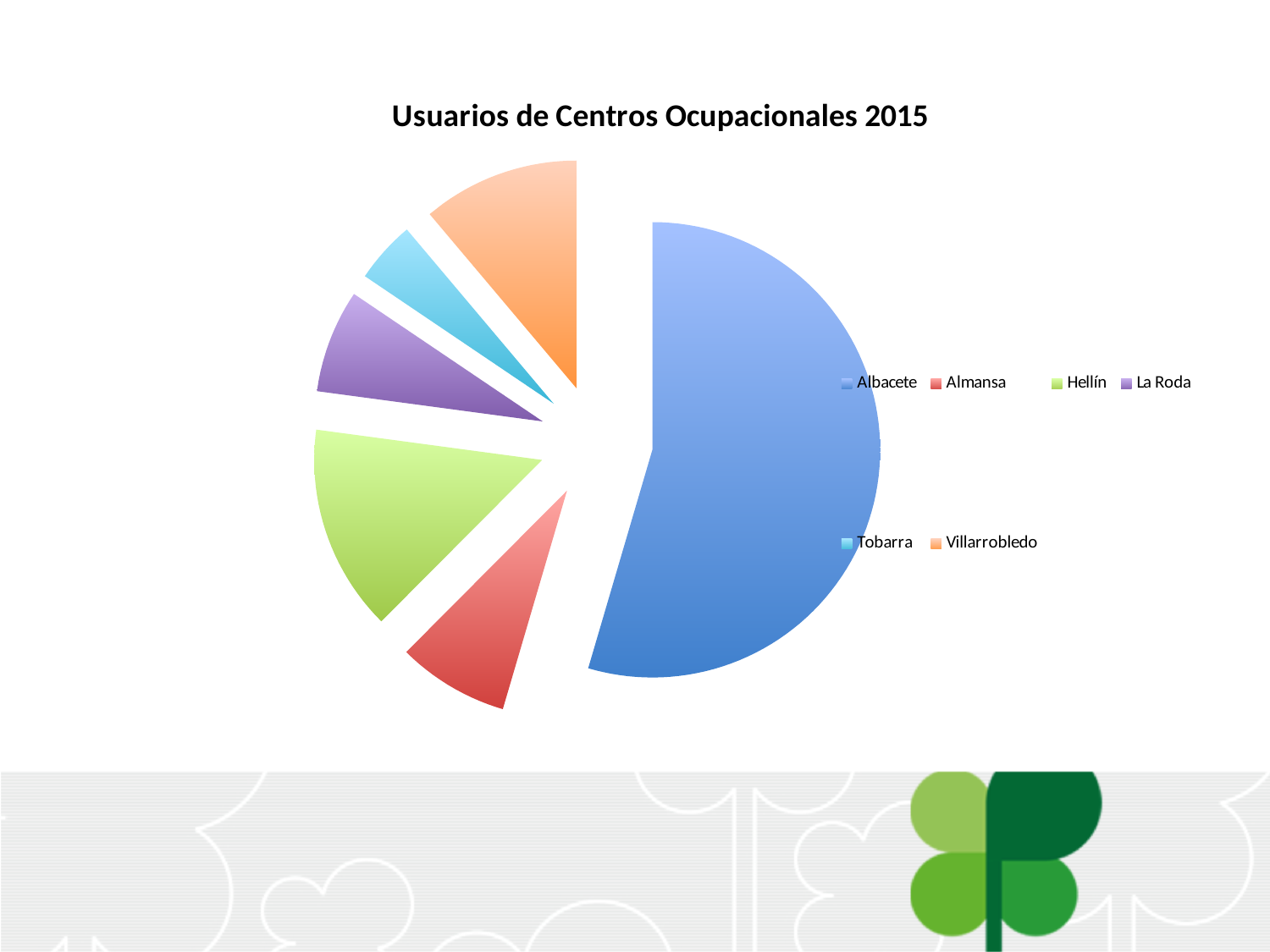
Which slice is larger, Hellín or La Roda? Hellín How many slices does the pie chart have? 6 What colour is the Albacete slice in the pie chart? blue What is the title of the chart? Usuarios de Centros Ocupacionales 2015 Which slice is larger, Albacete or Hellín? Albacete What kind of chart is shown on the slide? pie chart Which slice is larger, Hellín or Tobarra? Hellín Which category has the smallest slice of the pie? Tobarra Which category has the largest slice of the pie? Albacete